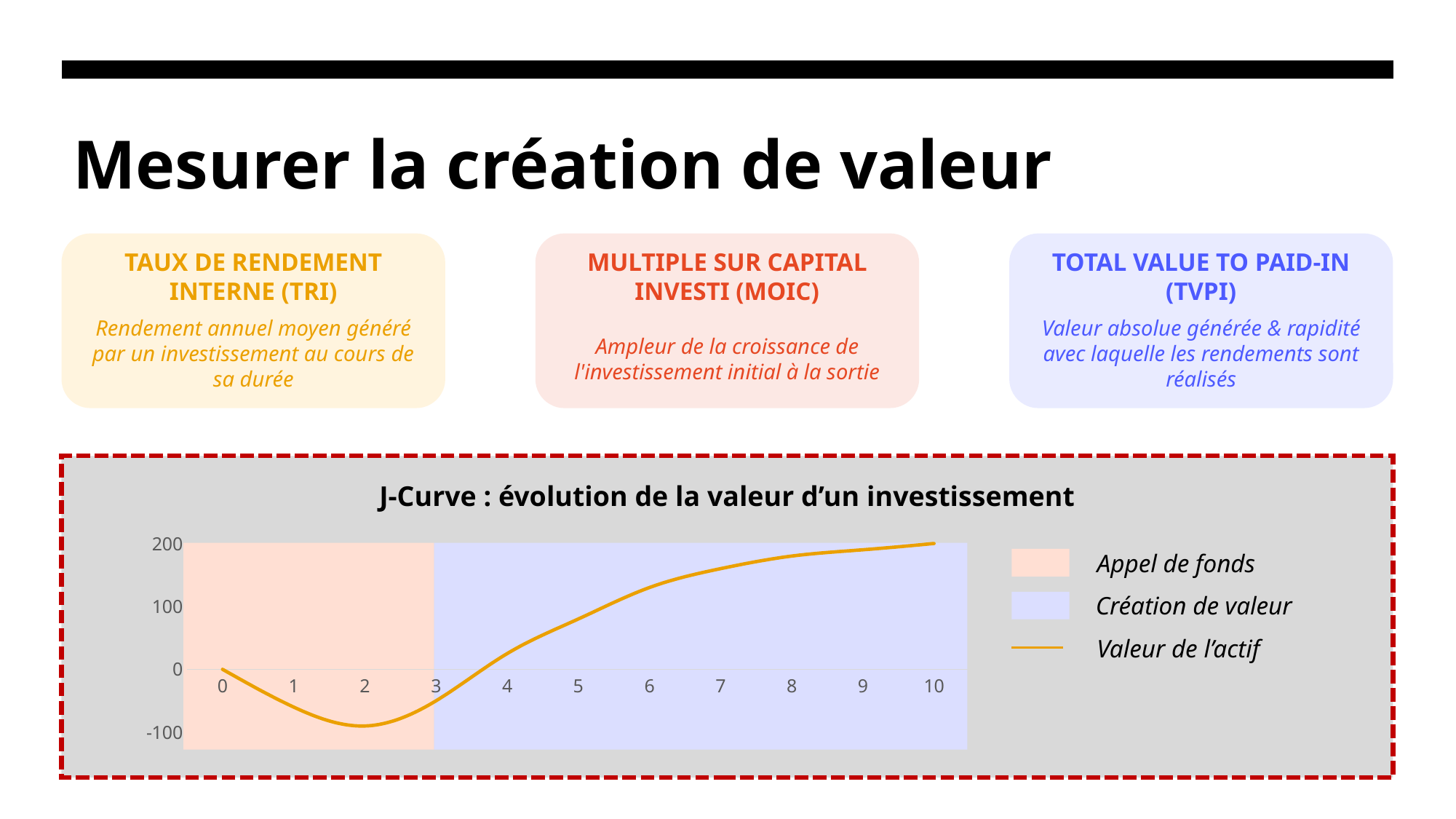
At which x value does the 'Valeur de l'actif' line reach its lowest point? 2 Between x = 3 and x = 10, does the 'Valeur de l'actif' line rise or fall? rise What is the value of 'Valeur de l'actif' at x = 0? 0 Is the value of 'Valeur de l'actif' at x = 8 greater or less than 100? greater How many entries does the chart's legend list? 3 What is the value of 'Valeur de l'actif' at x = 10? 200 At which x value does the 'Valeur de l'actif' line reach its highest point? 10 What is the title of the chart on the slide? J-Curve : évolution de la valeur d'un investissement What kind of chart is shown under the title 'J-Curve : évolution de la valeur d'un investissement'? line chart Is the value of 'Valeur de l'actif' at x = 1 greater or less than 0? less How many labelled points are there on the x axis of the chart? 11 Which is larger: the value of 'Valeur de l'actif' at x = 4 or at x = 7? x = 7